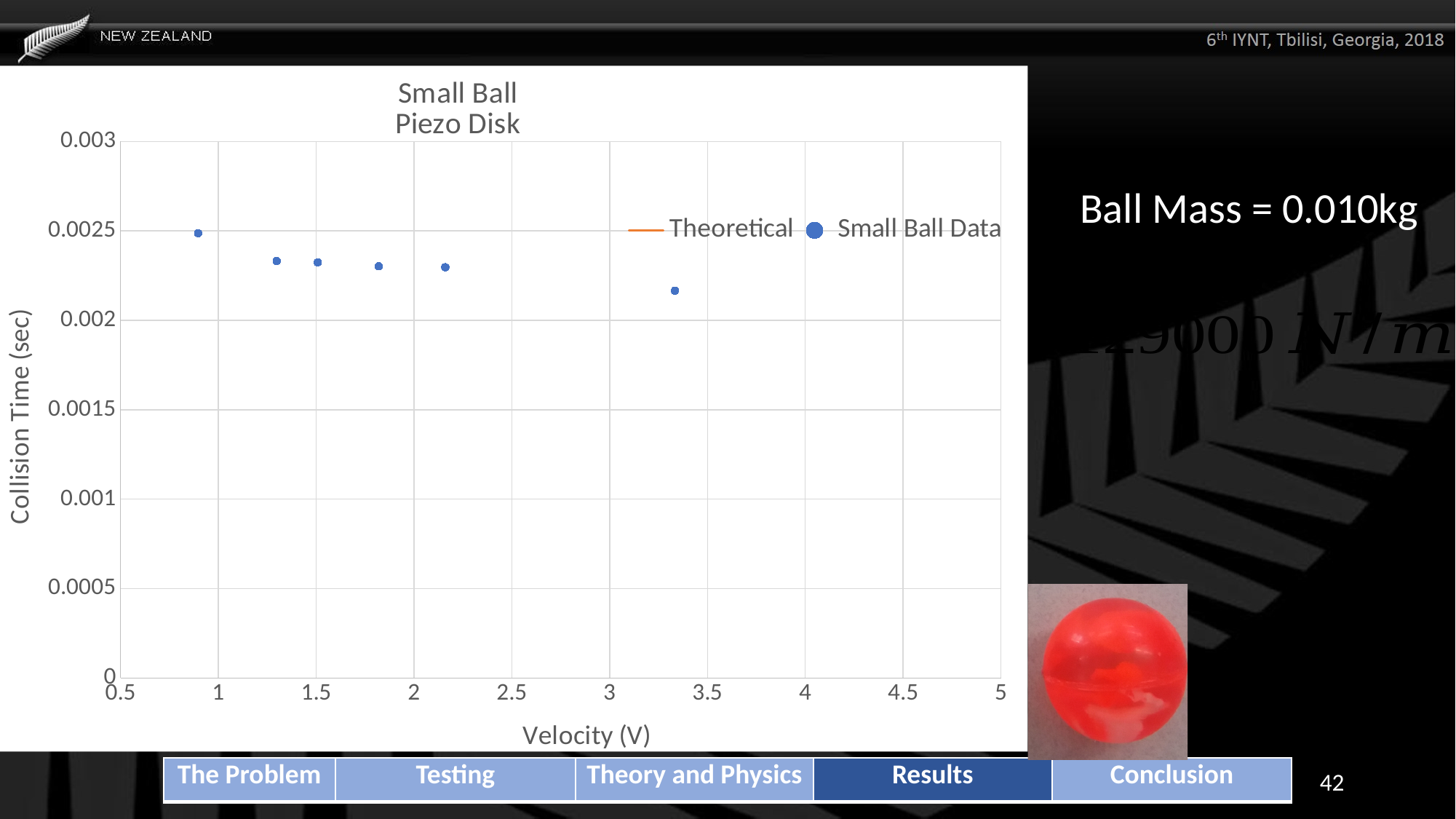
What is the title of the chart? Small Ball Piezo Disk How many series does the chart legend list? 2 Is the collision time of the leftmost Small Ball Data point greater or less than 0.002? greater How many Small Ball Data points are plotted on the chart? 6 What kind of chart is shown on the slide? Scatter chart What are the two series named in the chart legend? Theoretical and Small Ball Data What is the label of the x axis? Velocity (V) Which Small Ball Data point has the highest collision time: the one at the lowest velocity or the one at the highest velocity? The one at the lowest velocity Is the collision time of the rightmost Small Ball Data point greater or less than 0.0025? less Which Small Ball Data point has the lowest collision time: the one at the lowest velocity or the one at the highest velocity? The one at the highest velocity Do the Small Ball Data collision times rise or fall as velocity increases along the x axis? Fall